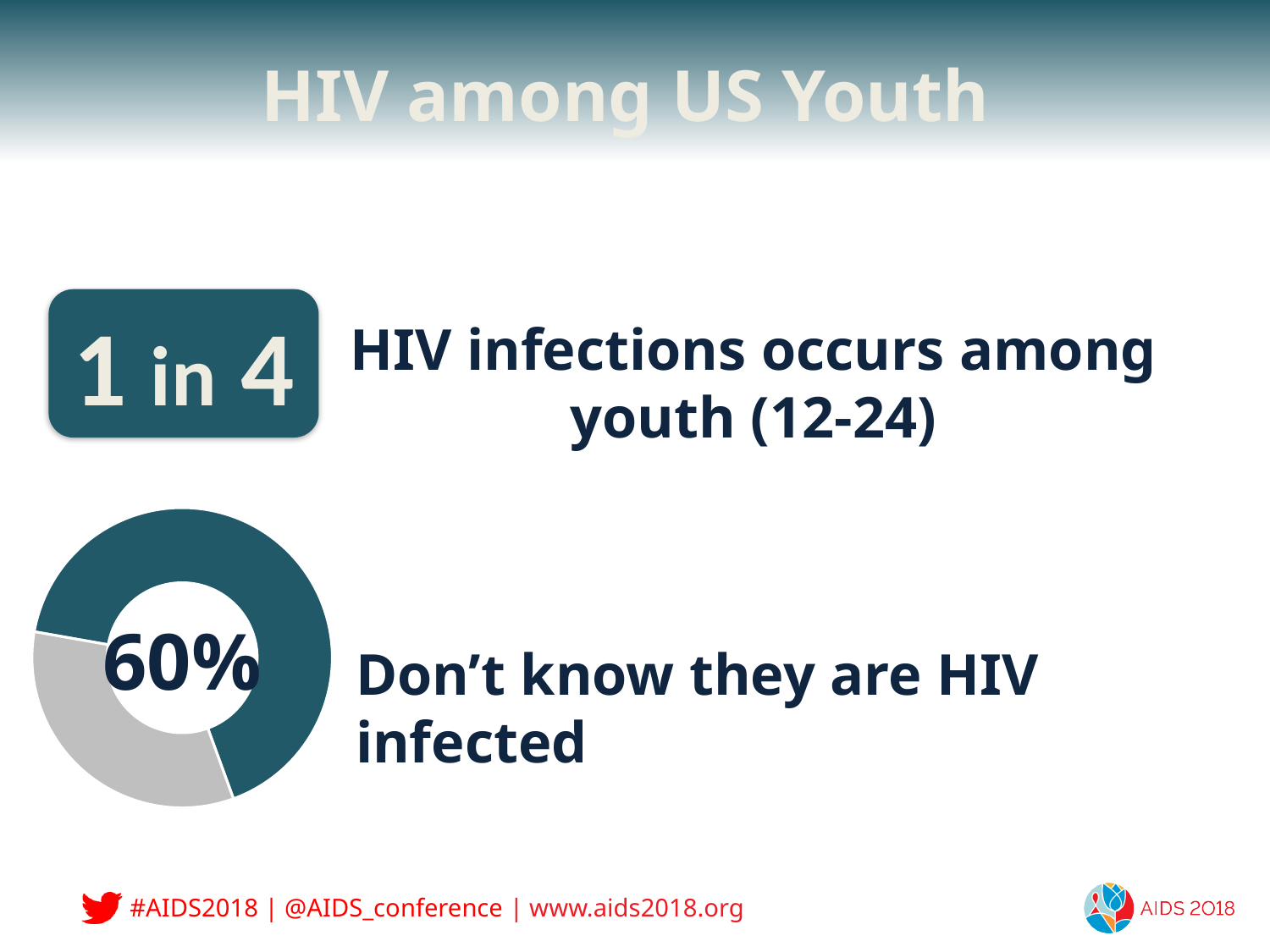
Is the teal slice of the donut chart greater or less than 50%? greater How many slices does the donut chart have? 2 What does the 60% in the donut chart represent, according to the text next to it? Don't know they are HIV infected Which slice of the donut chart is larger, the teal slice or the grey slice? The teal slice What is the title of the slide containing the donut chart? HIV among US Youth Is the grey slice of the donut chart greater or less than 50%? less What percentage is printed in the centre of the donut chart? 60% What kind of chart is shown on the slide? Donut (pie) chart